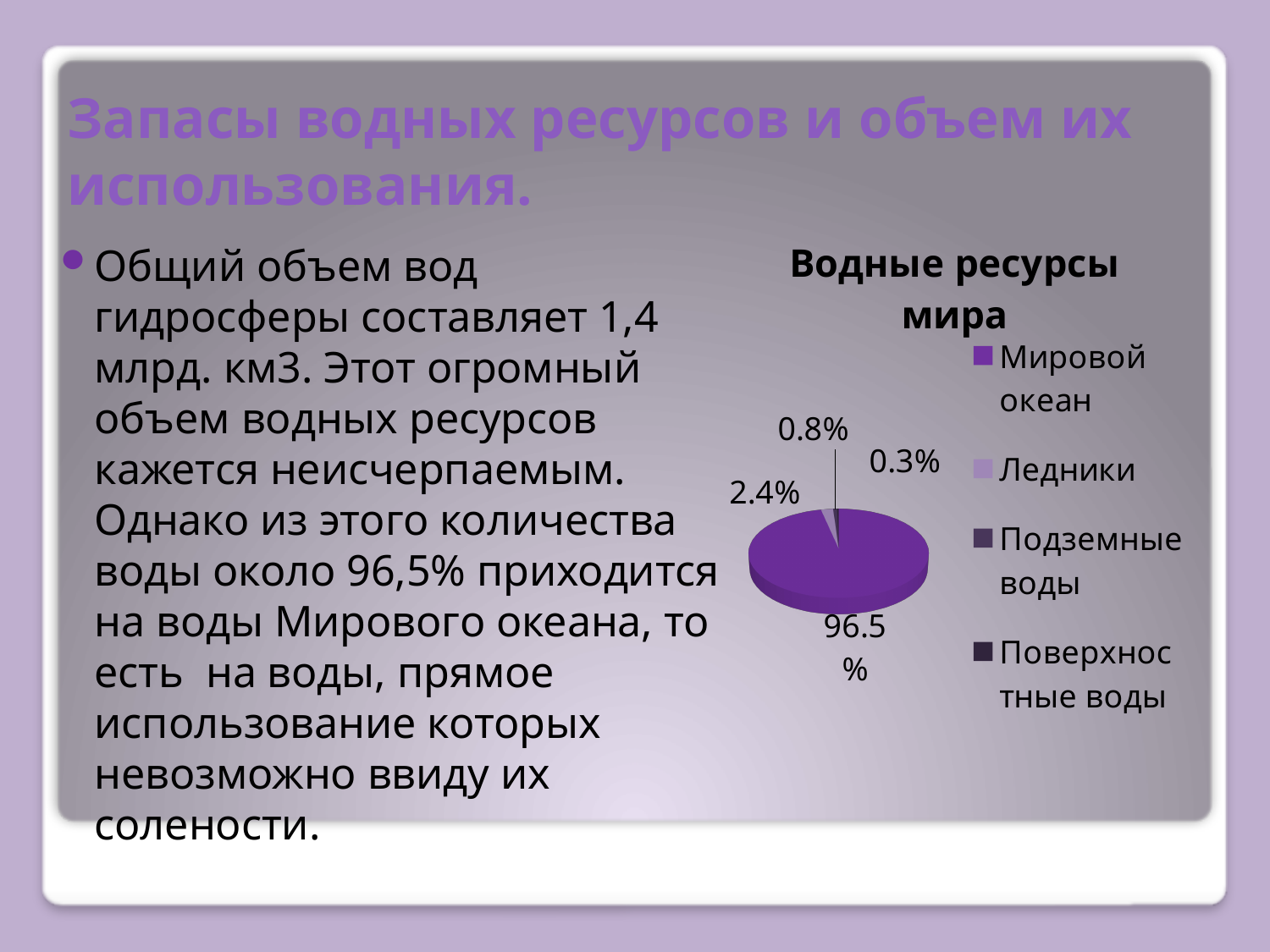
What share of the pie does Мировой океан have? 96.5% Which is larger, the value for Ледники or the value for Поверхностные воды? Ледники What is the title of the chart? Водные ресурсы мира What is the difference between the values for Ледники and Подземные воды? 1.6% How many categories does the pie chart show? 4 What kind of chart is shown on the slide? pie chart Which legend entry is listed first in the chart's legend? Мировой океан What is the value shown for Подземные воды? 0.8% Which category has the largest slice of the pie? Мировой океан Which category has the smallest slice of the pie? Поверхностные воды What is the value shown for Ледники? 2.4% What is the value shown for Поверхностные воды? 0.3%